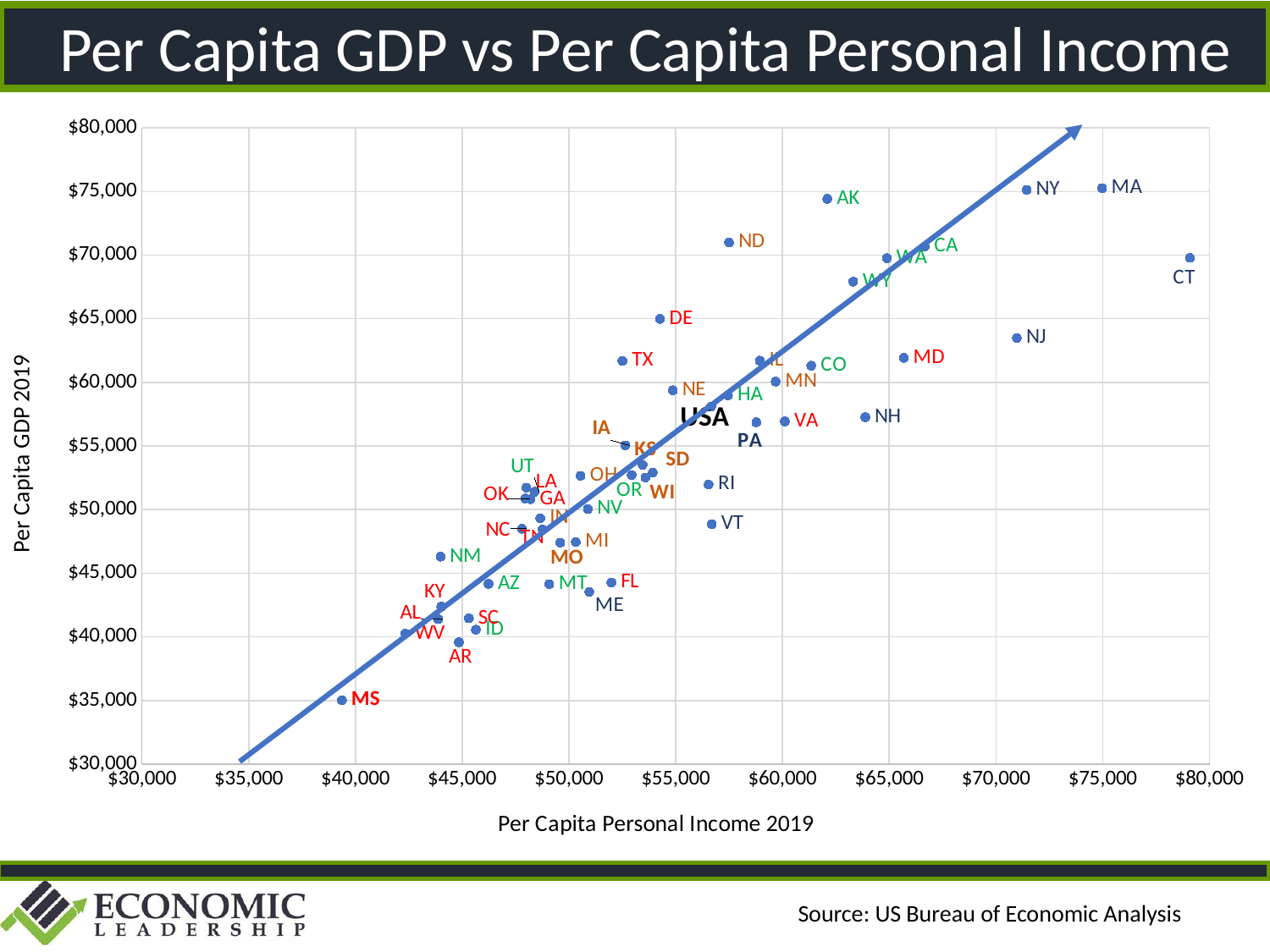
Which state has the highest per capita personal income on the chart? CT Is the per capita GDP for MS greater or less than $40,000? less Is the per capita GDP for AK greater or less than $70,000? greater Is the per capita personal income for CT greater or less than $75,000? greater Which state has the lowest per capita personal income on the chart? MS Which state has the lowest per capita GDP on the chart? MS What is the title of the x axis? Per Capita Personal Income 2019 What is the title of the y axis? Per Capita GDP 2019 Which has the higher per capita GDP, DE or TX? DE What kind of chart is shown on the slide? Scatter chart Do per capita GDP values generally rise or fall as per capita personal income increases along the x axis? rise